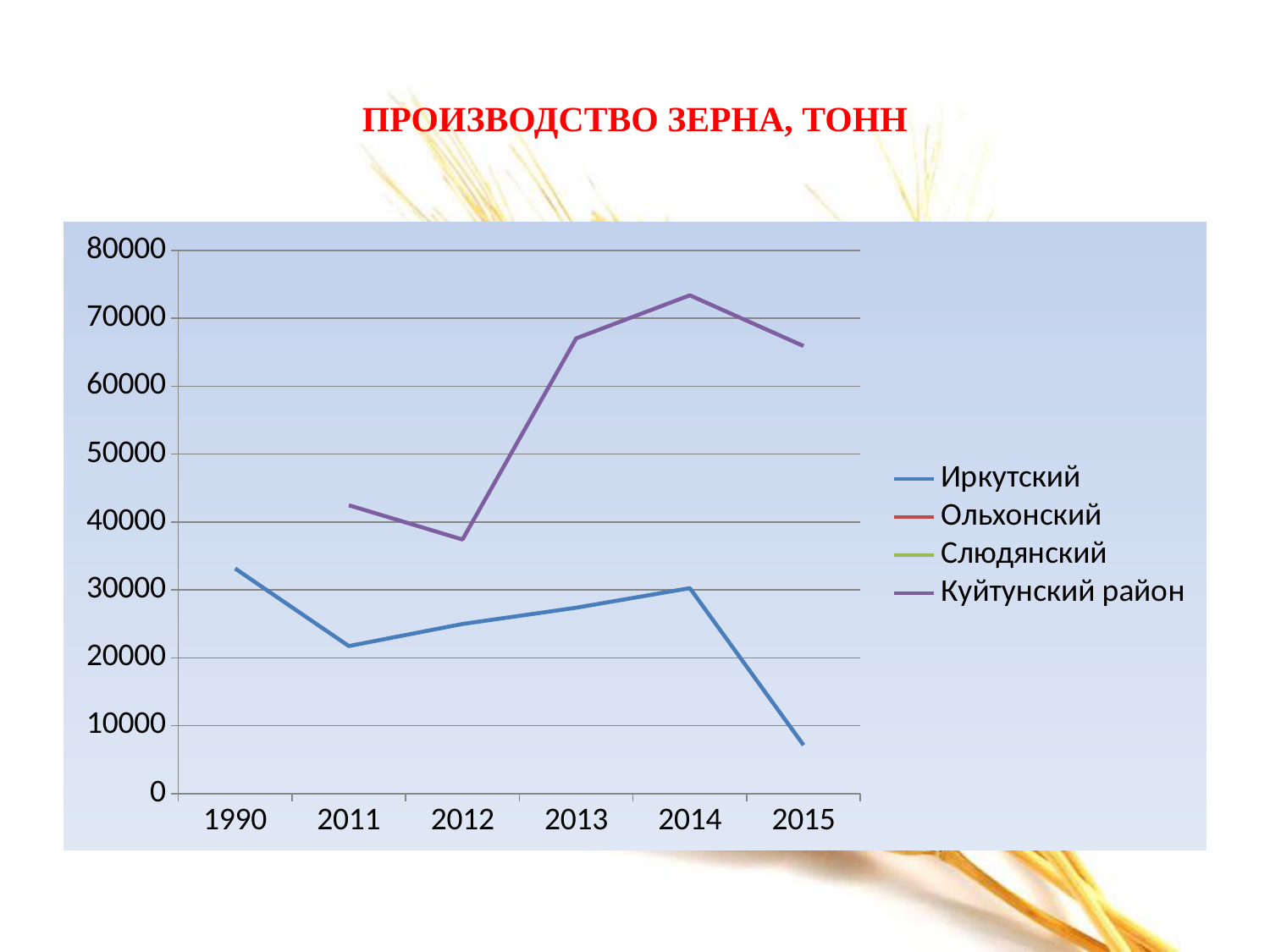
How many years are shown along the x axis? 6 In which year does the Иркутский series reach its lowest value? 2015 In which year does the Куйтунский район series reach its highest value? 2014 Does the Куйтунский район series rise or fall from 2012 to 2013? rise Is the value for Куйтунский район in 2014 greater or less than 70000? greater Is the value for Иркутский in 2015 greater or less than 10000? less Is the value for Куйтунский район in 2012 greater or less than 40000? less Which series has the larger value in 2013, Иркутский or Куйтунский район? Куйтунский район Does the Иркутский series rise or fall from 2014 to 2015? fall What is the title of the chart? ПРОИЗВОДСТВО ЗЕРНА, ТОНН How many series does the legend list? 4 What kind of chart is shown on the slide? line chart